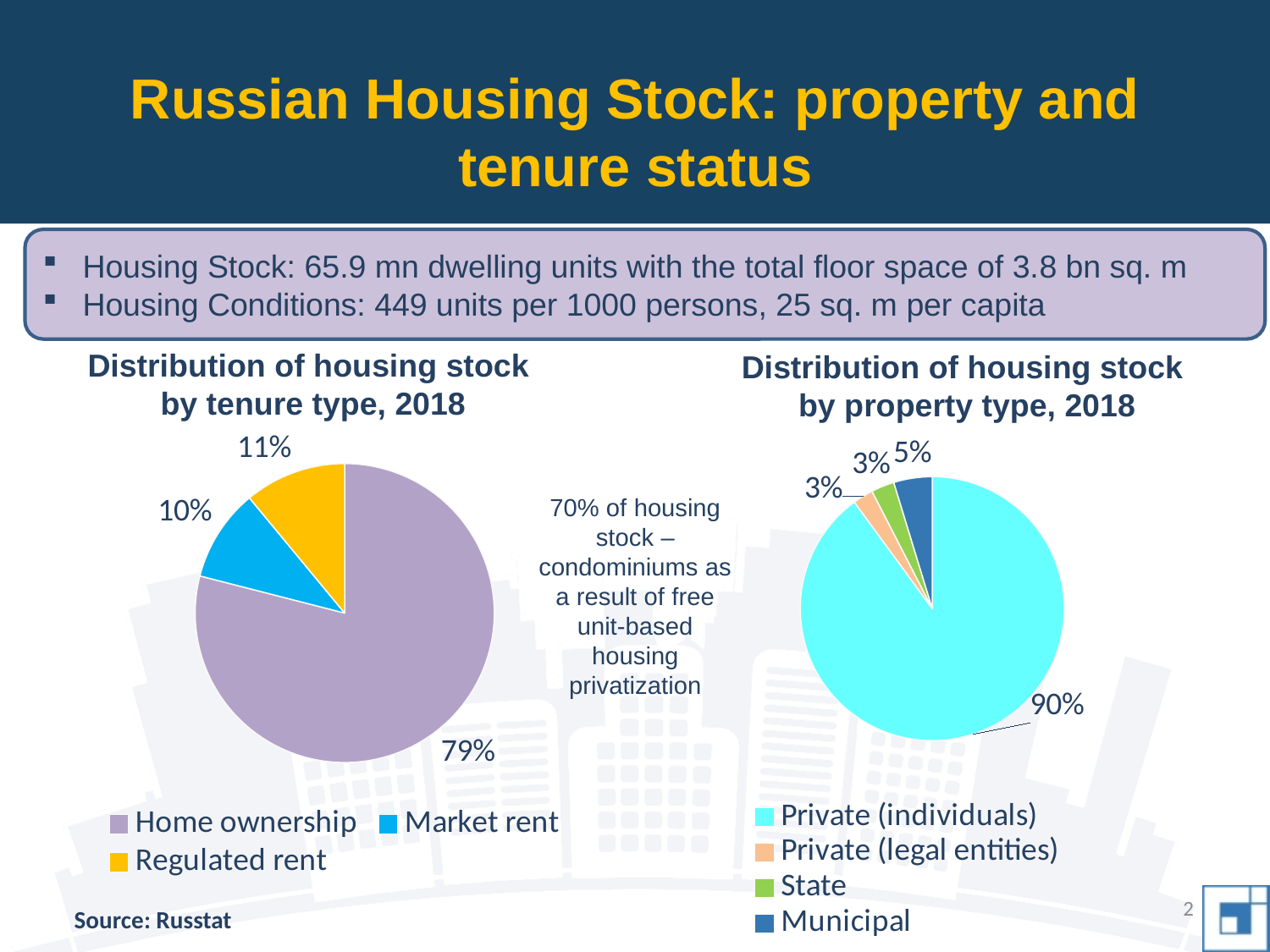
In the 'Distribution of housing stock by property type, 2018' chart, how many property types does the legend list? 4 In the 'Distribution of housing stock by tenure type, 2018' chart, what is the difference between the Home ownership share and the Regulated rent share? 68% In the 'Distribution of housing stock by property type, 2018' chart, which property type has the largest share? Private (individuals) In the 'Distribution of housing stock by property type, 2018' chart, what share is Municipal? 5% In the 'Distribution of housing stock by tenure type, 2018' chart, what share is Market rent? 10% In the 'Distribution of housing stock by tenure type, 2018' chart, what share is Regulated rent? 11% In the 'Distribution of housing stock by property type, 2018' chart, what share is Private (individuals)? 90% In the 'Distribution of housing stock by tenure type, 2018' chart, what share is Home ownership? 79% In the 'Distribution of housing stock by tenure type, 2018' chart, which tenure type has the smallest share? Market rent In the 'Distribution of housing stock by tenure type, 2018' chart, how many tenure types are shown? 3 In the 'Distribution of housing stock by property type, 2018' chart, what share is State? 3% What type of chart is used for the 'Distribution of housing stock by property type, 2018'? Pie chart